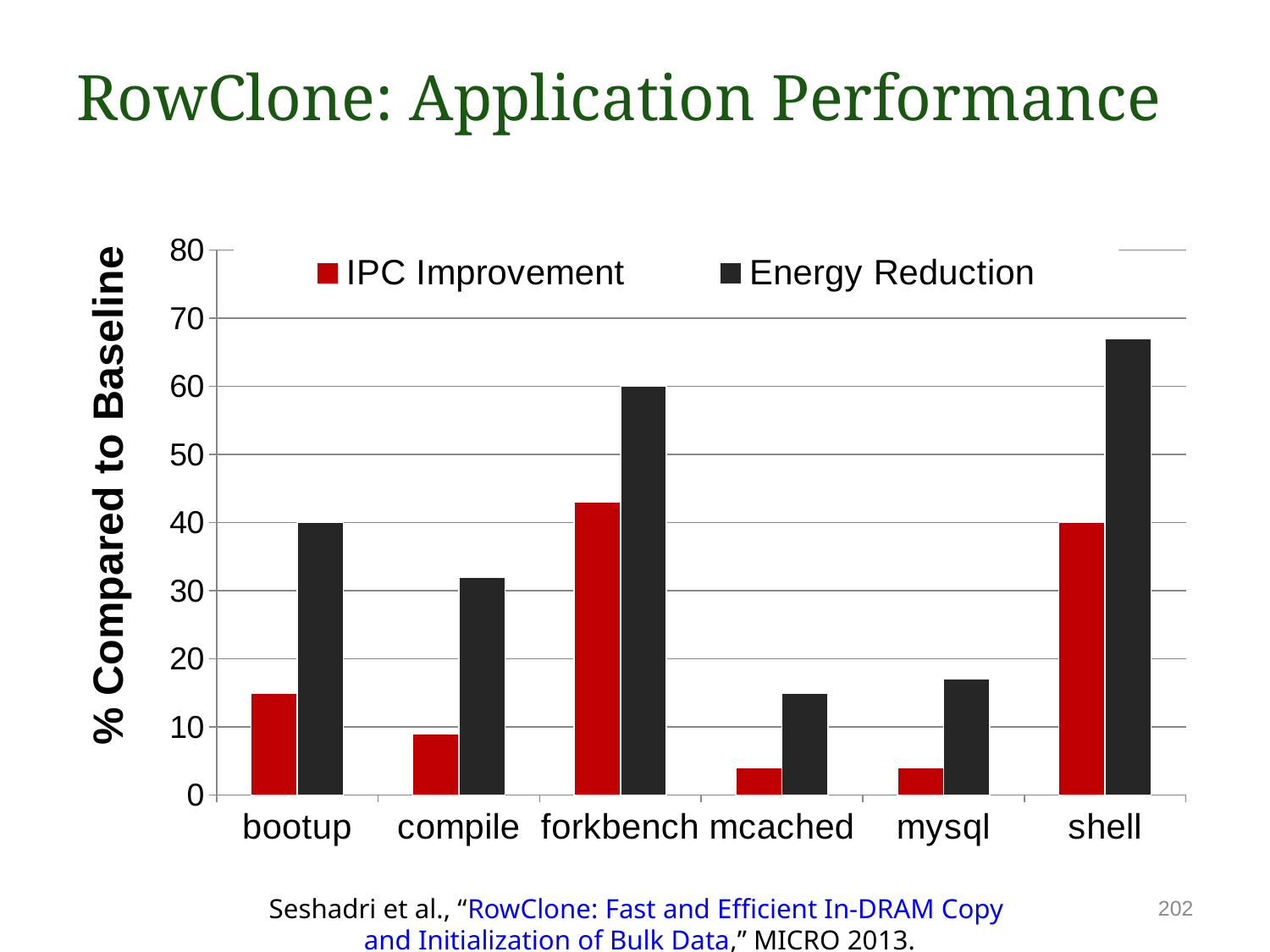
What is the label of the y axis? % Compared to Baseline Which application has the highest IPC Improvement? forkbench How many application categories are shown on the x axis? 6 Is the Energy Reduction for compile greater or less than 30? greater What kind of chart is shown on the slide? bar chart Is the Energy Reduction for shell greater or less than 60? greater How many series does the legend list? 2 Is the IPC Improvement for mysql greater or less than 10? less Which colour represents IPC Improvement in the legend? red Which is larger, the Energy Reduction for bootup or the Energy Reduction for compile? bootup Which application has the highest Energy Reduction? shell